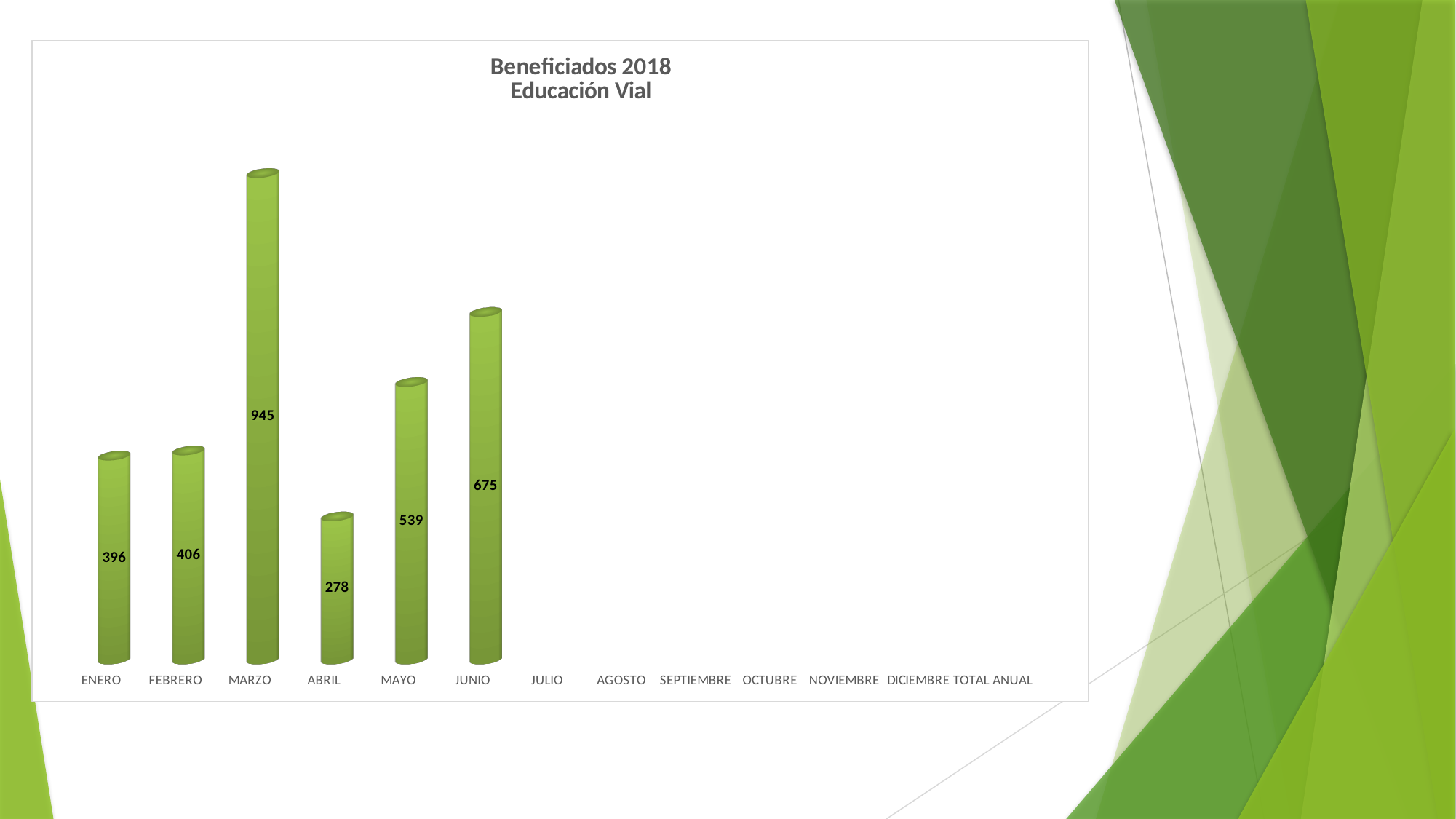
What is the difference between the values for MARZO and JUNIO? 270 Which month has the lowest value among the plotted bars? ABRIL What kind of chart is shown? Bar chart Which month has the highest value? MARZO How many bars are plotted on the chart? 6 What is the value for JUNIO? 675 What is the value for ENERO? 396 What is the difference between the values for FEBRERO and ENERO? 10 What is the value for MARZO? 945 What is the value for ABRIL? 278 Which is larger, the value for MAYO or the value for JUNIO? JUNIO What is the title of the chart? Beneficiados 2018 Educación Vial